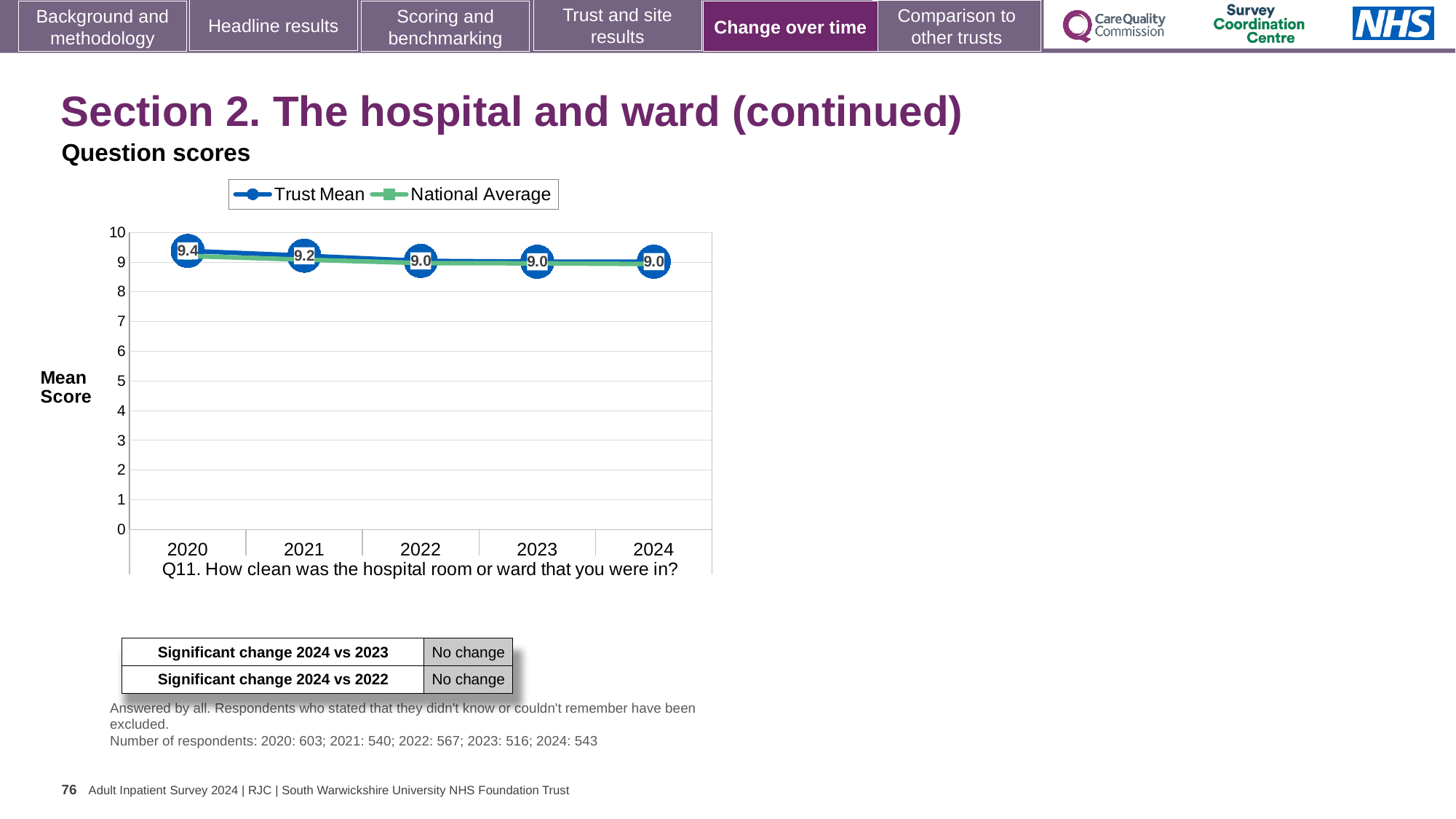
What is the Trust Mean value for 2020? 9.4 What kind of chart is shown on the slide? Line chart How many years are shown on the x axis? 5 In which year is the Trust Mean highest? 2020 Which survey question does the chart relate to? Q11. How clean was the hospital room or ward that you were in? Which is larger, the Trust Mean for 2020 or for 2021? 2020 What is the Trust Mean value for 2021? 9.2 How many series does the legend list? 2 What is the Trust Mean value for 2024? 9.0 Is the National Average value for 2020 greater or less than 8? greater What is the difference between the Trust Mean in 2020 and in 2024? 0.4 Does the Trust Mean rise or fall from 2020 to 2024? Fall